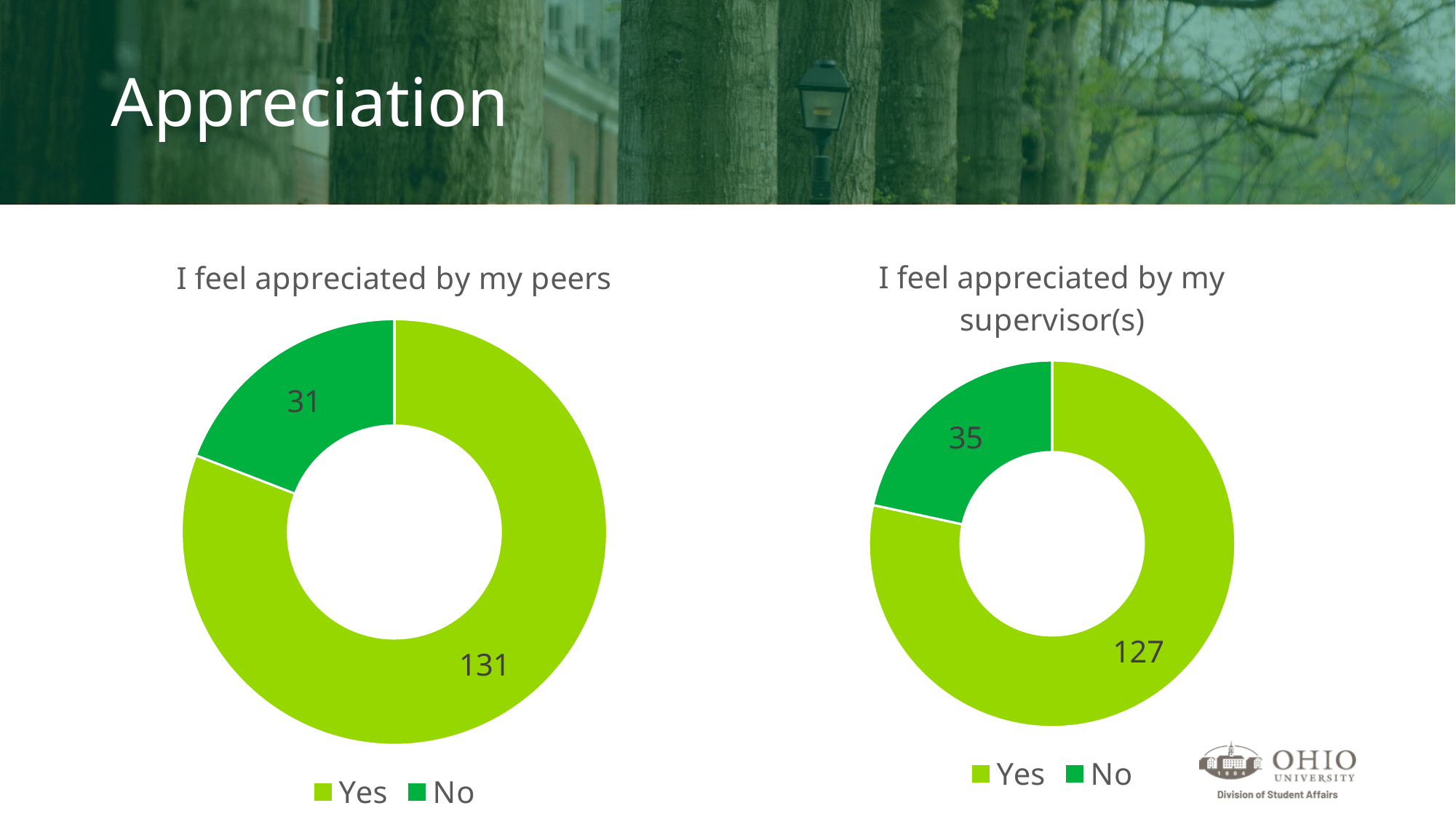
In the chart titled "I feel appreciated by my peers", how many respondents answered Yes? 131 What type of chart is used on the left side of the slide? Doughnut (pie) chart How many entries does the legend of the chart titled "I feel appreciated by my supervisor(s)" list? 2 In the chart titled "I feel appreciated by my supervisor(s)", which response has the smaller slice? No In the chart titled "I feel appreciated by my peers", which response has the larger slice? Yes In the chart titled "I feel appreciated by my peers", how many respondents answered No? 31 In the chart titled "I feel appreciated by my peers", what is the difference between the Yes and No counts? 100 In the chart titled "I feel appreciated by my supervisor(s)", what is the difference between the Yes and No counts? 92 Which chart has the larger No count, the peers chart or the supervisor(s) chart? The supervisor(s) chart In the chart titled "I feel appreciated by my supervisor(s)", how many respondents answered No? 35 In the chart titled "I feel appreciated by my supervisor(s)", how many respondents answered Yes? 127 In the chart titled "I feel appreciated by my peers", what is the total number of responses? 162